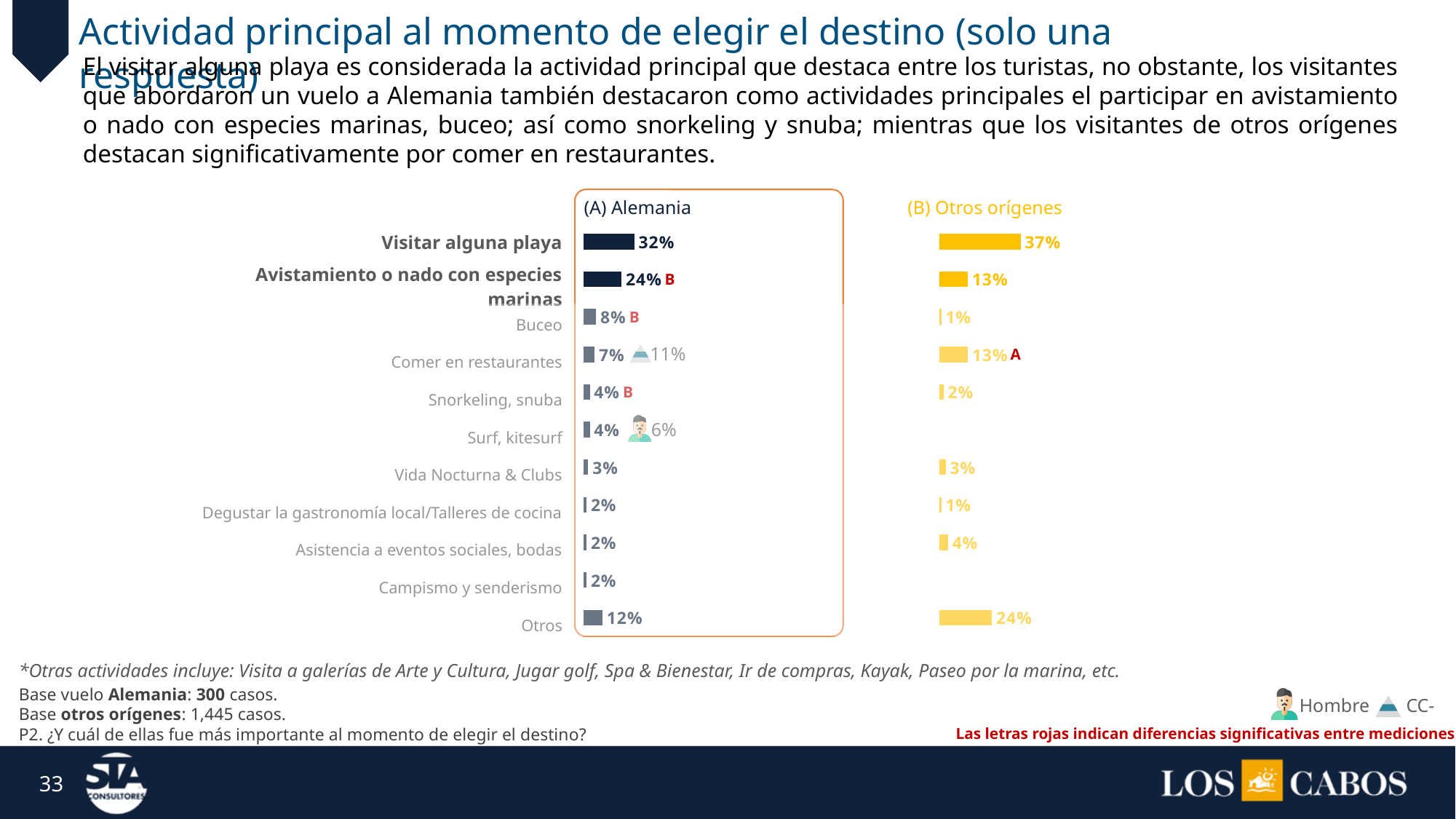
In the (B) Otros orígenes chart, which activity has the highest value? Visitar alguna playa In the (B) Otros orígenes chart, what is the value for Comer en restaurantes? 13% What is the difference between the Visitar alguna playa values in the (B) Otros orígenes chart and the (A) Alemania chart? 5% In the (B) Otros orígenes chart, what is the value for Otros? 24% How many activity categories are listed in the (A) Alemania chart? 11 In the (A) Alemania chart, which activity has the highest value? Visitar alguna playa In the (A) Alemania chart, what is the value for Visitar alguna playa? 32% In the (A) Alemania chart, what is the value for Avistamiento o nado con especies marinas? 24% What is the difference between the Avistamiento o nado con especies marinas values in the (A) Alemania chart and the (B) Otros orígenes chart? 11% For Buceo, which chart shows the larger value, (A) Alemania or (B) Otros orígenes? (A) Alemania What kind of chart is used to show the (A) Alemania data? Bar chart In the (B) Otros orígenes chart, what is the value for Visitar alguna playa? 37%